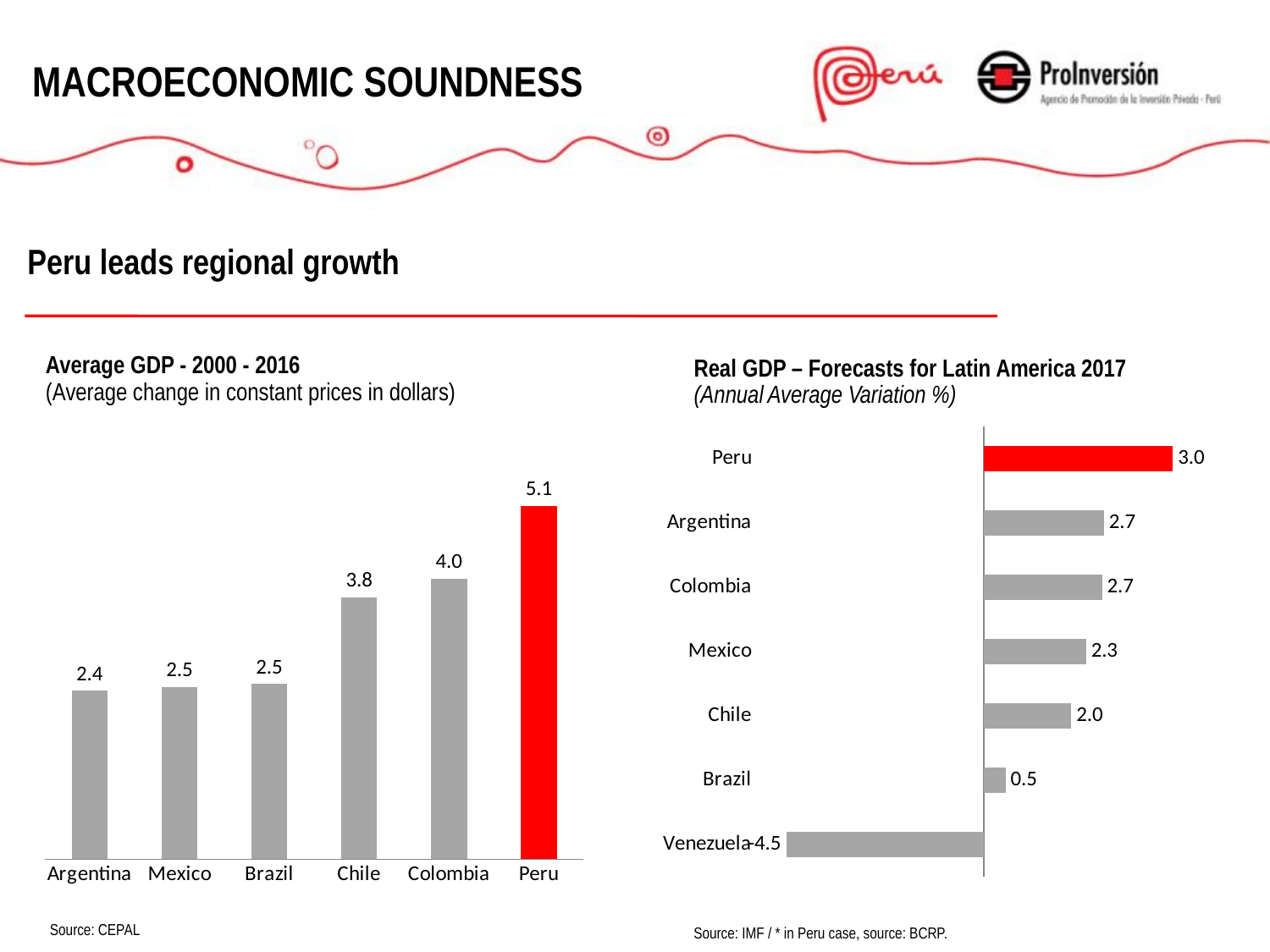
In the 'Average GDP - 2000 - 2016' chart, what is the difference between Peru and Colombia? 1.1 In the 'Average GDP - 2000 - 2016' chart, which country has the lowest value? Argentina In the 'Real GDP – Forecasts for Latin America 2017' chart, what is the value for Mexico? 2.3 In the 'Average GDP - 2000 - 2016' chart, which country has the highest value? Peru In the 'Real GDP – Forecasts for Latin America 2017' chart, what is the value for Venezuela? -4.5 In the 'Average GDP - 2000 - 2016' chart, what is the value for Chile? 3.8 What type of chart is the 'Average GDP - 2000 - 2016' chart? Bar chart In the 'Average GDP - 2000 - 2016' chart, how many countries are shown? 6 In the 'Real GDP – Forecasts for Latin America 2017' chart, what is the difference between Peru and Argentina? 0.3 In the 'Real GDP – Forecasts for Latin America 2017' chart, which is larger, Chile or Brazil? Chile In the 'Real GDP – Forecasts for Latin America 2017' chart, which country's bar is coloured red? Peru In the 'Real GDP – Forecasts for Latin America 2017' chart, which country has the lowest value? Venezuela